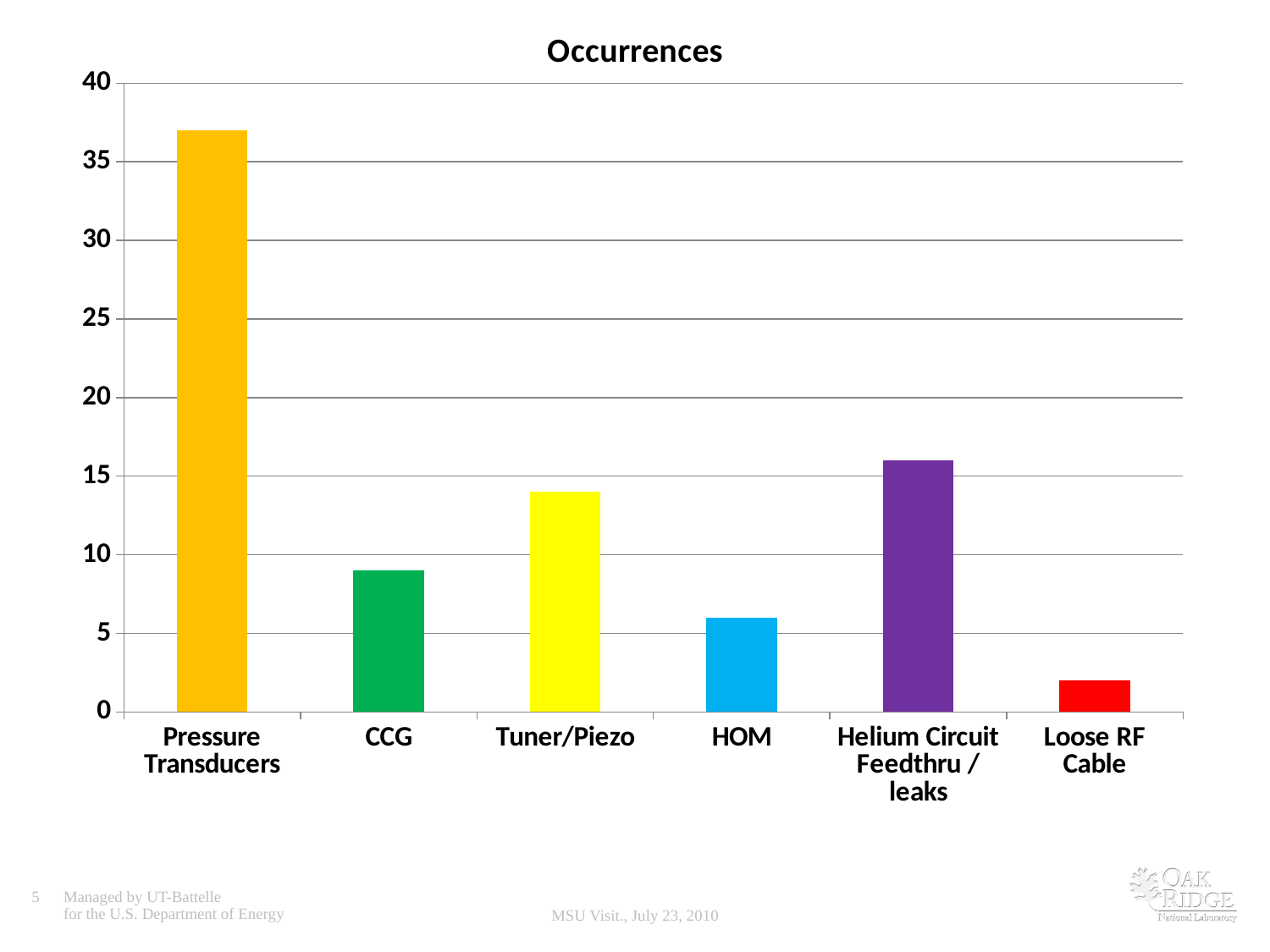
Is the value for CCG greater or less than 10? less Which category has the highest number of occurrences? Pressure Transducers Which has more occurrences, Tuner/Piezo or HOM? Tuner/Piezo Which has more occurrences, CCG or Helium Circuit Feedthru / leaks? Helium Circuit Feedthru / leaks What type of chart is shown on the slide? bar chart What is the title of the chart? Occurrences Which category has the lowest number of occurrences? Loose RF Cable Is the value for HOM greater or less than 5? greater How many categories are shown on the x axis of the chart? 6 Is the value for Tuner/Piezo greater or less than 15? less